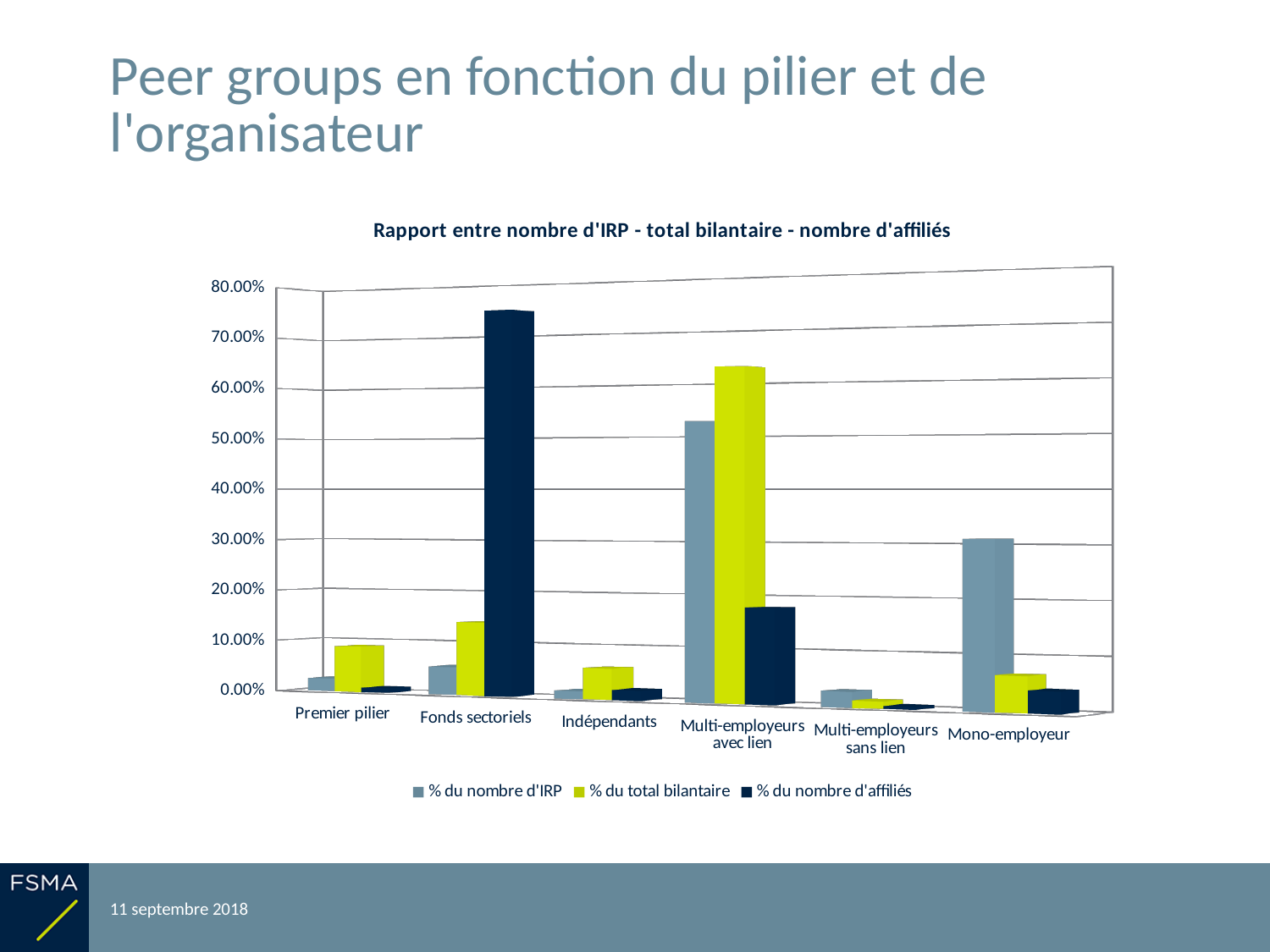
How many series does the legend list? 3 Is the value for % du total bilantaire for Multi-employeurs avec lien greater or less than 60.00%? greater Is the value for % du nombre d'affiliés for Fonds sectoriels greater or less than 70.00%? greater Which is larger: % du nombre d'affiliés for Fonds sectoriels or % du total bilantaire for Multi-employeurs avec lien? % du nombre d'affiliés for Fonds sectoriels How many categories are shown on the x axis? 6 What kind of chart is shown on the slide? Bar chart Which category has the highest value for % du nombre d'affiliés? Fonds sectoriels What is the title of the chart? Rapport entre nombre d'IRP - total bilantaire - nombre d'affiliés Is the value for % du nombre d'IRP for Mono-employeur greater or less than 20.00%? greater Which category has the highest value for % du nombre d'IRP? Multi-employeurs avec lien Which category has the highest value for % du total bilantaire? Multi-employeurs avec lien